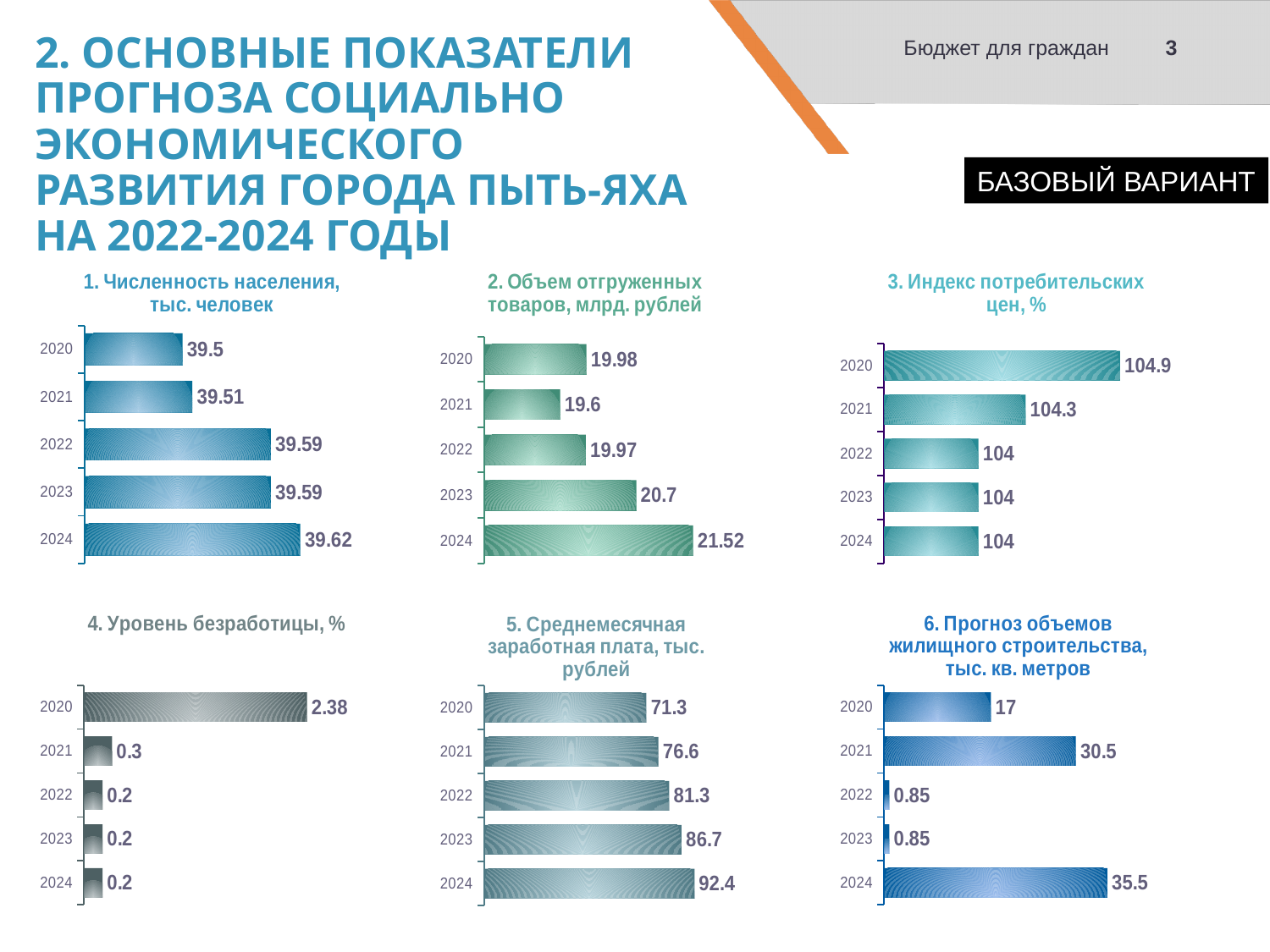
In the chart "3. Индекс потребительских цен, %", which year has the highest value? 2020 In the chart "5. Среднемесячная заработная плата, тыс. рублей", what is the difference between the 2024 and 2020 values? 21.1 In the chart "2. Объем отгруженных товаров, млрд. рублей", which year has the lowest value? 2021 In the chart "2. Объем отгруженных товаров, млрд. рублей", what is the difference between the 2024 and 2023 values? 0.82 In the chart "6. Прогноз объемов жилищного строительства, тыс. кв. метров", what is the value for 2022? 0.85 In the chart "6. Прогноз объемов жилищного строительства, тыс. кв. метров", which is larger, the value for 2021 or the value for 2024? 2024 In the chart "4. Уровень безработицы, %", how many years are shown? 5 In the chart "1. Численность населения, тыс. человек", what is the value for 2024? 39.62 In the chart "3. Индекс потребительских цен, %", what is the value for 2021? 104.3 In the chart "4. Уровень безработицы, %", what is the value for 2020? 2.38 What type of chart is "1. Численность населения, тыс. человек"? bar chart In the chart "5. Среднемесячная заработная плата, тыс. рублей", do the values rise or fall from 2020 to 2024? rise